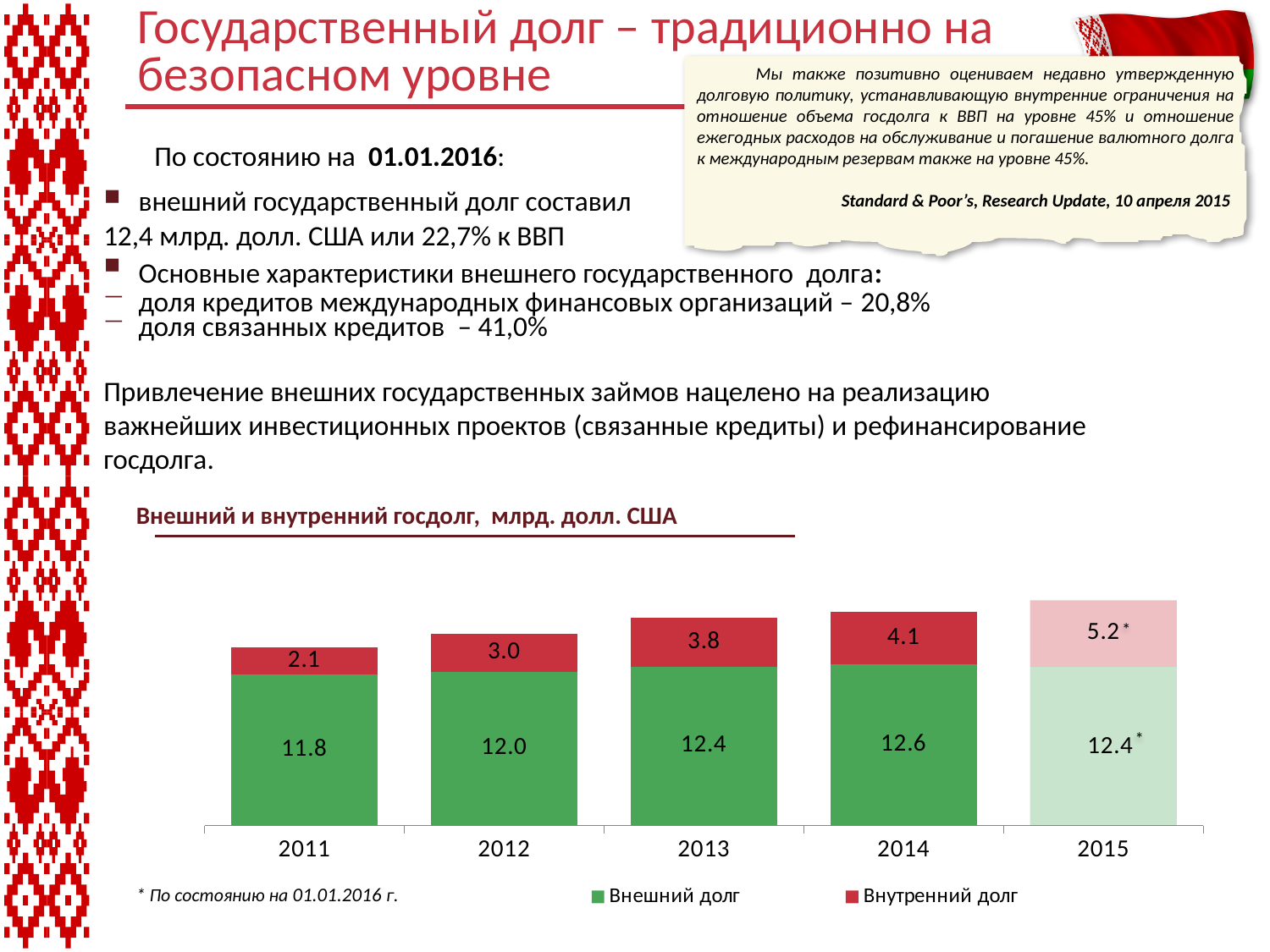
What is the total government debt (Внешний долг plus Внутренний долг) for 2014? 16.7 How many series does the chart legend list? 2 How many years are shown on the x axis of the chart? 5 In which year is Внешний долг the lowest? 2011 What is the value of Внешний долг for 2013? 12.4 Does Внутренний долг rise or fall from 2011 to 2015? Rises What is the value of Внутренний долг for 2015? 5.2 What is the value of Внутренний долг for 2012? 3.0 In which year is Внутренний долг the highest? 2015 Which is larger: Внешний долг in 2014 or Внешний долг in 2012? Внешний долг in 2014 What is the difference between Внутренний долг in 2015 and in 2011? 3.1 What type of chart is shown on the slide? Stacked bar chart